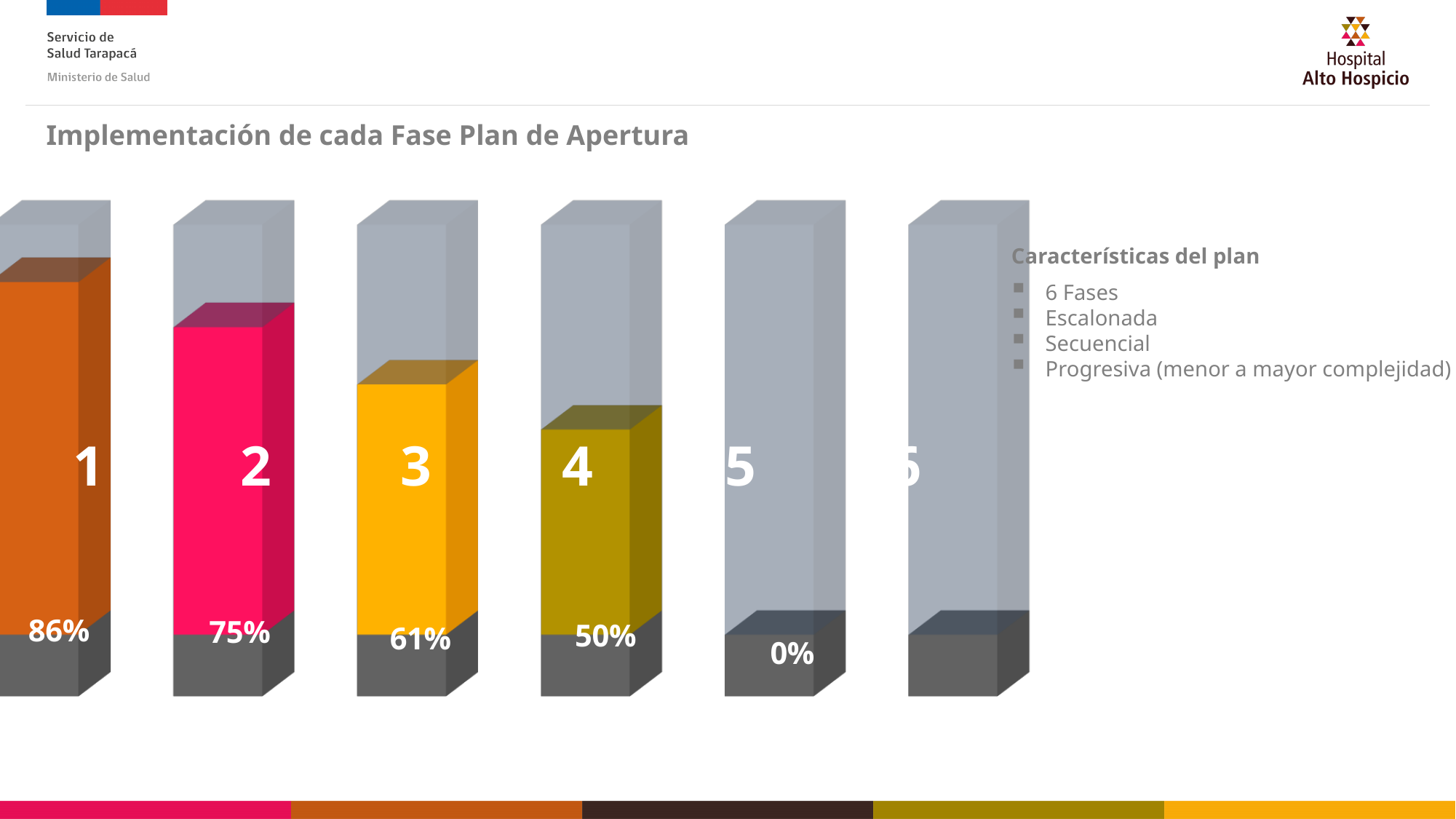
Which phase has the highest implementation percentage? Phase 1 What is the implementation percentage shown for phase 5? 0% Which has a higher implementation percentage, phase 2 or phase 3? Phase 2 What is the implementation percentage shown for phase 2? 75% What is the difference in percentage points between phase 3 and phase 4? 11 What is the implementation percentage shown for phase 3? 61% Do the implementation percentages rise or fall from phase 1 to phase 5? Fall What is the implementation percentage shown for phase 4? 50% What kind of chart is shown on the slide? Bar chart What is the implementation percentage shown for phase 1? 86% How many phases (bars) does the chart show? 6 What is the difference in percentage points between phase 1 and phase 2? 11